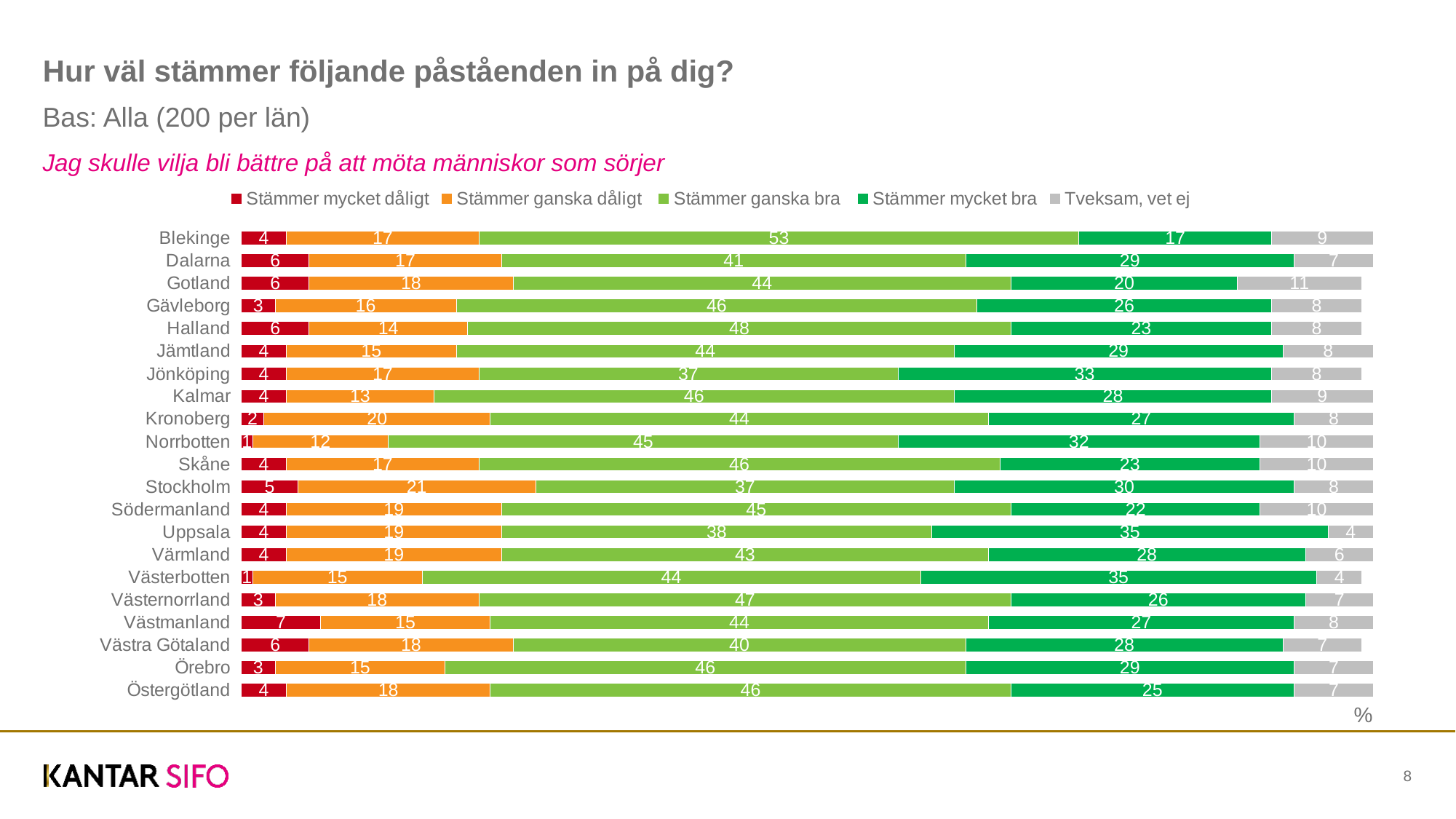
What is the difference between the "Stämmer ganska bra" values for Blekinge and Stockholm? 16 Which county has the highest value for "Stämmer mycket dåligt"? Västmanland How many counties are shown in the chart? 21 Which county has the lowest value for "Stämmer ganska dåligt"? Norrbotten What percentage of respondents in Blekinge answered "Stämmer ganska bra"? 53 Which county has the lowest value for "Stämmer mycket bra"? Blekinge What is the "Tveksam, vet ej" value for Gotland? 11 What is the value for "Stämmer mycket bra" in Jönköping? 33 How many series does the legend list? 5 Which county has the highest value for "Stämmer ganska bra"? Blekinge Which is larger: the "Stämmer mycket bra" value for Uppsala or for Halland? Uppsala What kind of chart is shown on the slide? Stacked bar chart